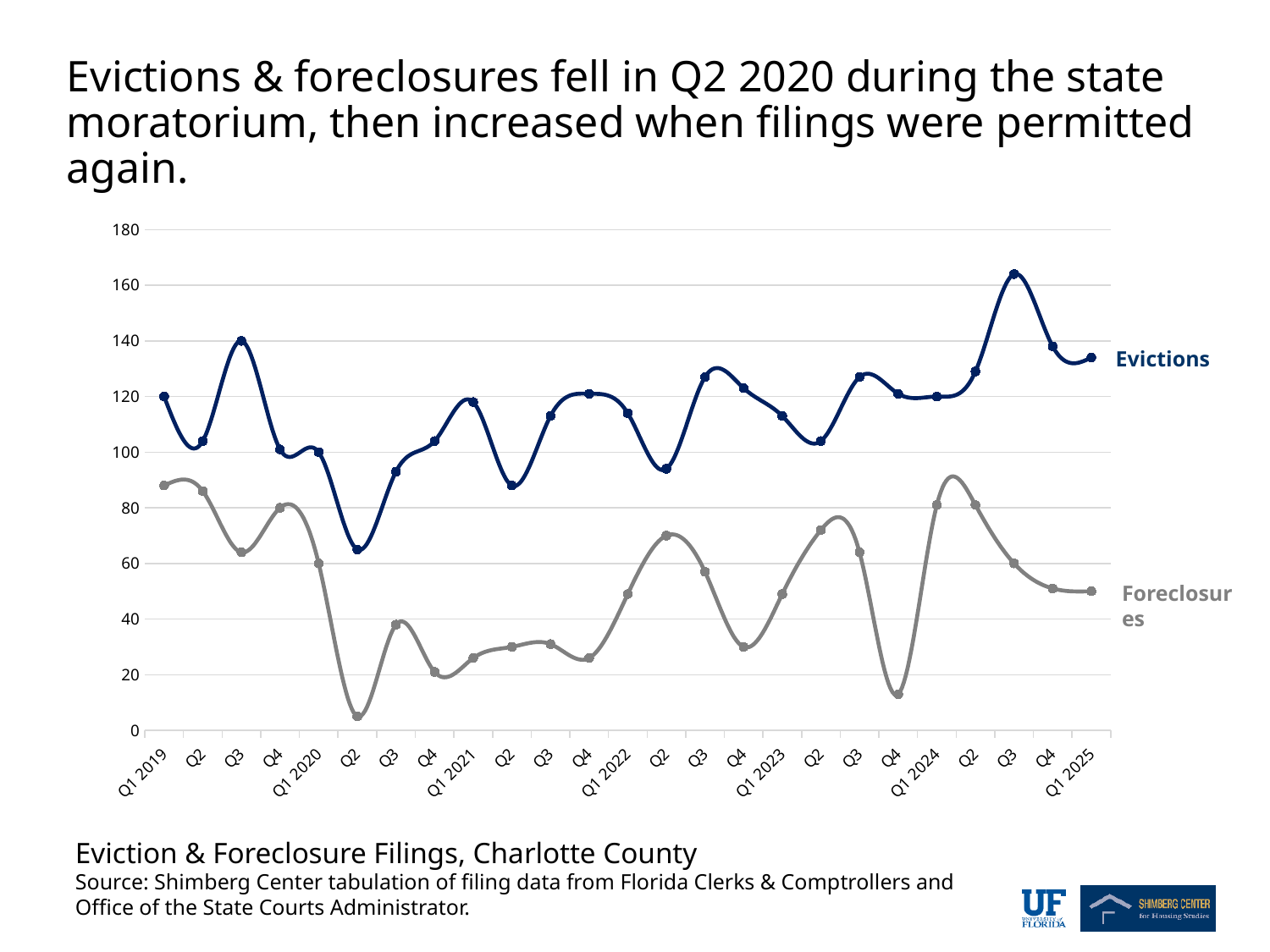
How many quarters are plotted along the x axis? 25 Is the value for Evictions in Q2 2020 greater or less than 80? less What is the value of Evictions in Q3 2019? 140 What kind of chart is shown on the slide? Line chart In which quarter do Evictions reach their highest value? Q3 2024 What is the value of Foreclosures in Q1 2020? 60 Is the value for Foreclosures in Q4 2023 greater or less than 20? less What is the value of Evictions in Q1 2019? 120 In which quarter do Foreclosures reach their lowest value? Q2 2020 Which series has the larger value in Q1 2025, Evictions or Foreclosures? Evictions What is the title of the chart given below it? Eviction & Foreclosure Filings, Charlotte County How many series are plotted on the chart? 2